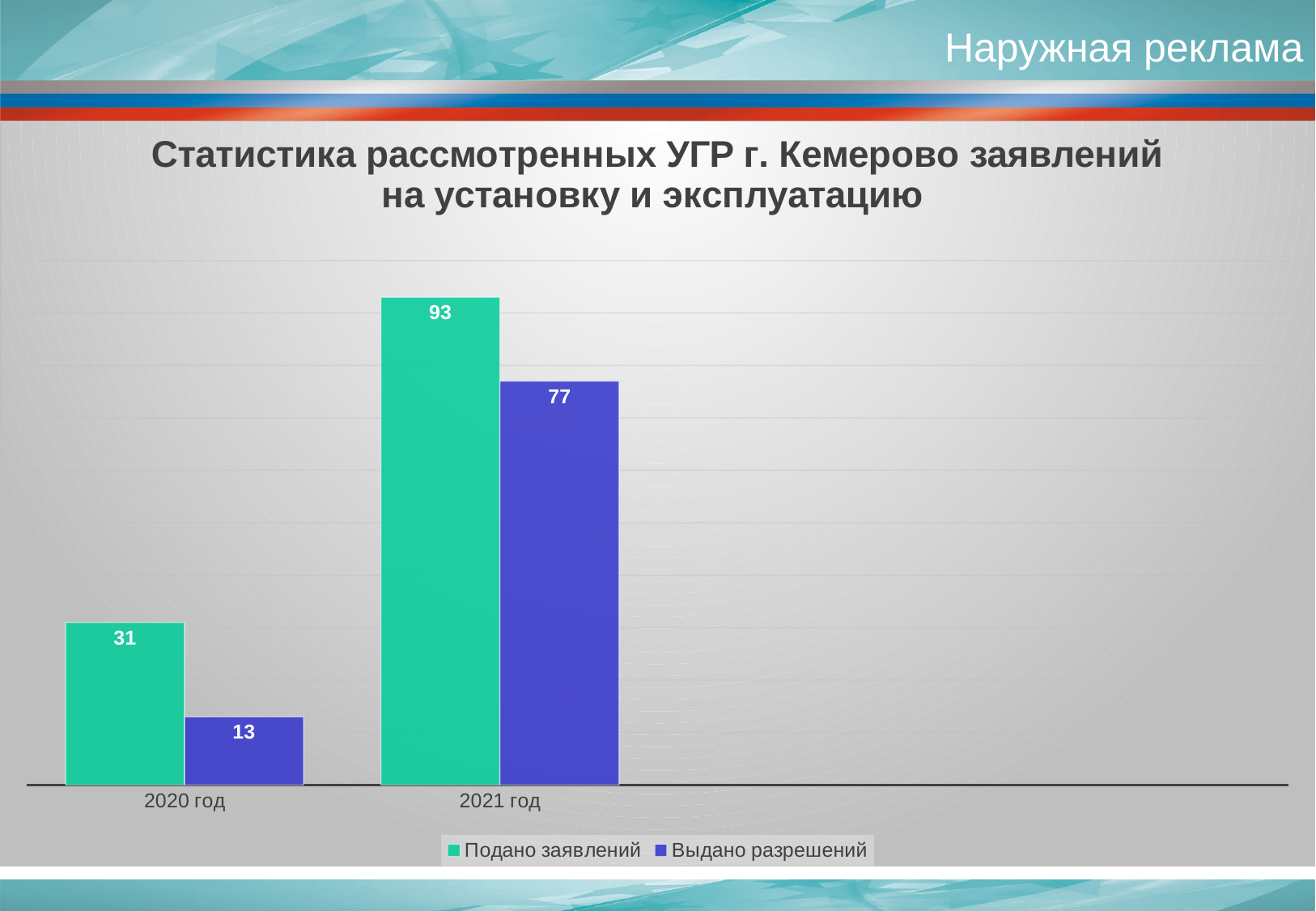
Which year has the lowest value for "Выдано разрешений"? 2020 год What is the value of "Выдано разрешений" for 2021 год? 77 What is the value of "Выдано разрешений" for 2020 год? 13 What is the difference between "Подано заявлений" in 2021 год and in 2020 год? 62 What kind of chart is shown on the slide? Bar chart What is the difference between "Подано заявлений" and "Выдано разрешений" in 2021 год? 16 Which is larger: "Выдано разрешений" in 2021 год or "Подано заявлений" in 2020 год? Выдано разрешений in 2021 год What is the value of "Подано заявлений" for 2020 год? 31 Which year has the highest value for "Подано заявлений"? 2021 год How many year categories are shown on the x axis? 2 How many series does the legend list? 2 Do the values for "Выдано разрешений" rise or fall from 2020 год to 2021 год? Rise